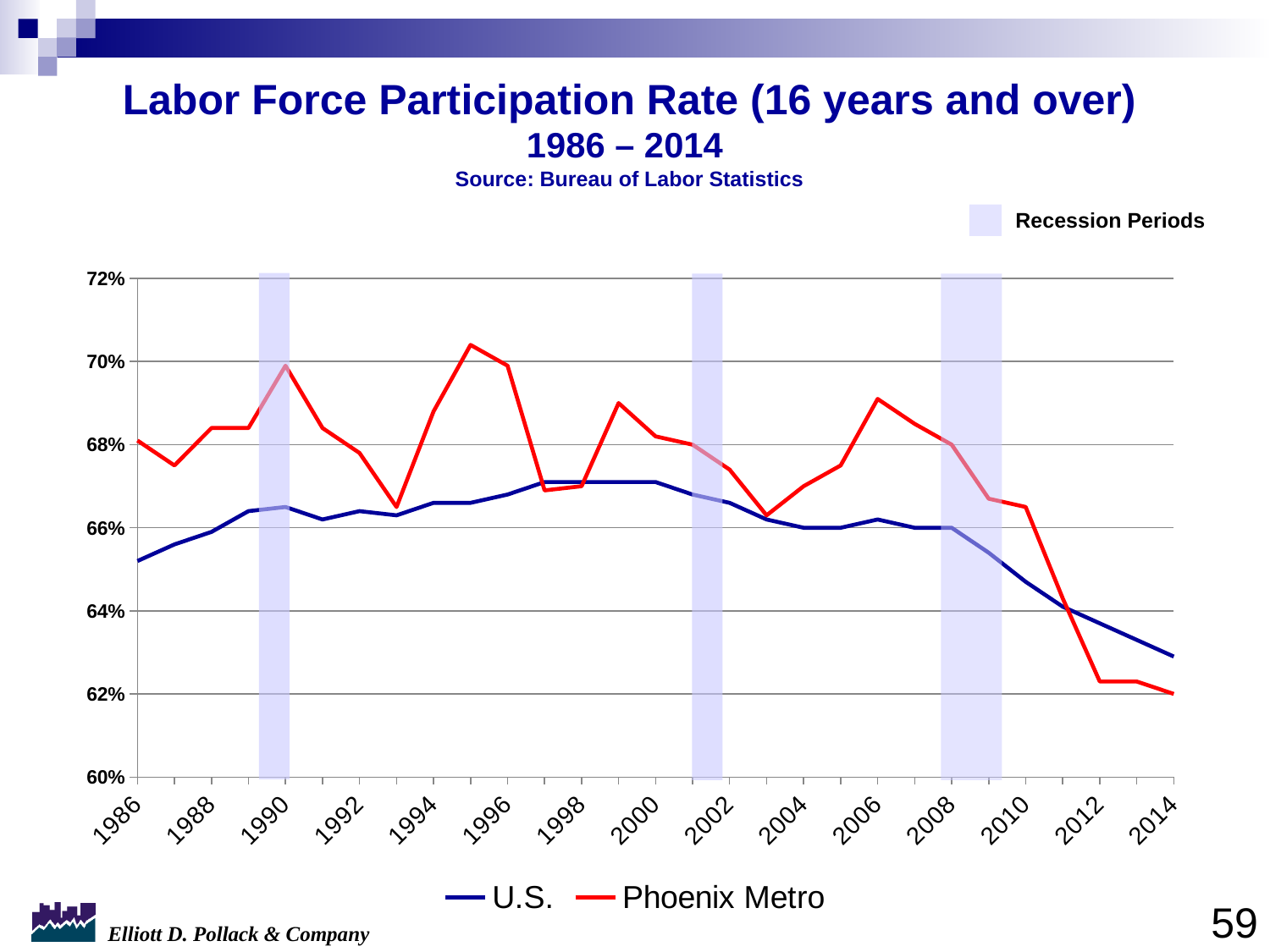
Is the U.S. value for 2014 greater or less than 62%? greater Is the Phoenix Metro value for 2006 greater or less than 68%? greater In 2014, which series has the higher value, U.S. or Phoenix Metro? U.S. Is the Phoenix Metro value for 1995 greater or less than 70%? greater Does the U.S. line rise or fall from 2008 to 2014? fall In 1995, which series has the higher value, U.S. or Phoenix Metro? Phoenix Metro What colour is the Phoenix Metro line? red What kind of chart is shown on the slide? line chart Which two series are shown in the legend? U.S. and Phoenix Metro How many shaded recession periods are marked on the chart? 3 How many series does the legend list? 2